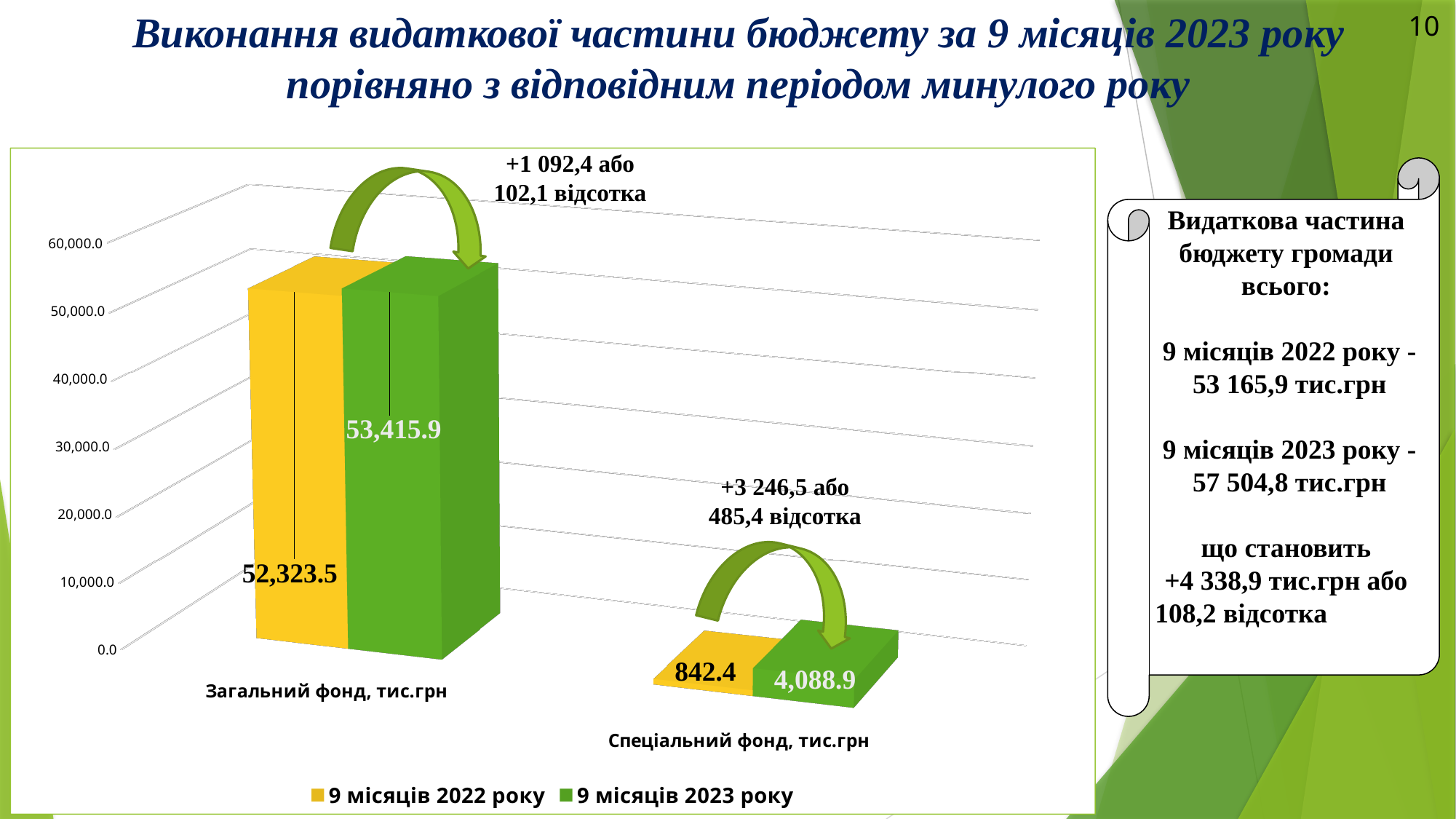
What is the difference between the 9 місяців 2023 року and 9 місяців 2022 року values for Загальний фонд? 1,092.4 Which category has the lowest value in the 9 місяців 2022 року series? Спеціальний фонд Which is larger for Спеціальний фонд: the 9 місяців 2022 року value or the 9 місяців 2023 року value? 9 місяців 2023 року What is the value for Загальний фонд for 9 місяців 2023 року? 53,415.9 What kind of chart is shown on the slide? bar chart What is the value for Спеціальний фонд for 9 місяців 2022 року? 842.4 How many series does the legend list? 2 What is the value for Спеціальний фонд for 9 місяців 2023 року? 4,088.9 Which category has the highest value in the 9 місяців 2023 року series? Загальний фонд Is the value for Загальний фонд in 9 місяців 2022 року greater or less than 50,000? greater What is the value for Загальний фонд for 9 місяців 2022 року? 52,323.5 What is the difference between the 9 місяців 2023 року and 9 місяців 2022 року values for Спеціальний фонд? 3,246.5